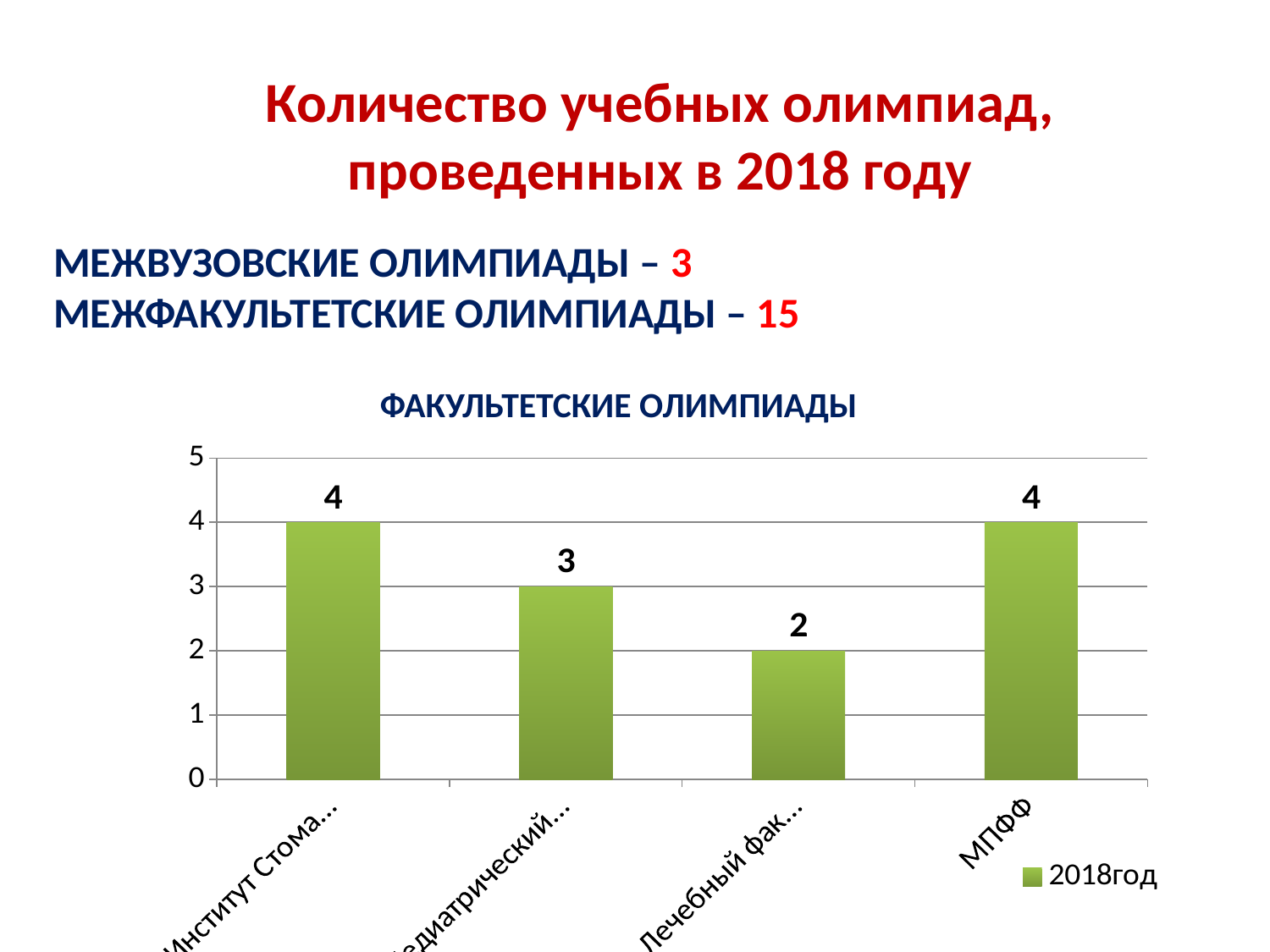
What is the value for МПФФ? 4 What is the value for the category labelled "Лечебный фак…"? 2 How many bars (categories) does the chart show? 4 Which is larger, the value for the second bar from the left or the value for "Лечебный фак…"? the second bar from the left What is the value for the category labelled "Институт Стома…"? 4 What type of chart is shown on the slide? bar chart How many series does the chart legend list? 1 What is the difference between the value for МПФФ and the value for "Лечебный фак…"? 2 What series name is shown in the chart legend? 2018год What is the value of the second bar from the left? 3 What is the title of the chart? ФАКУЛЬТЕТСКИЕ ОЛИМПИАДЫ Which category has the lowest value? Лечебный фак…